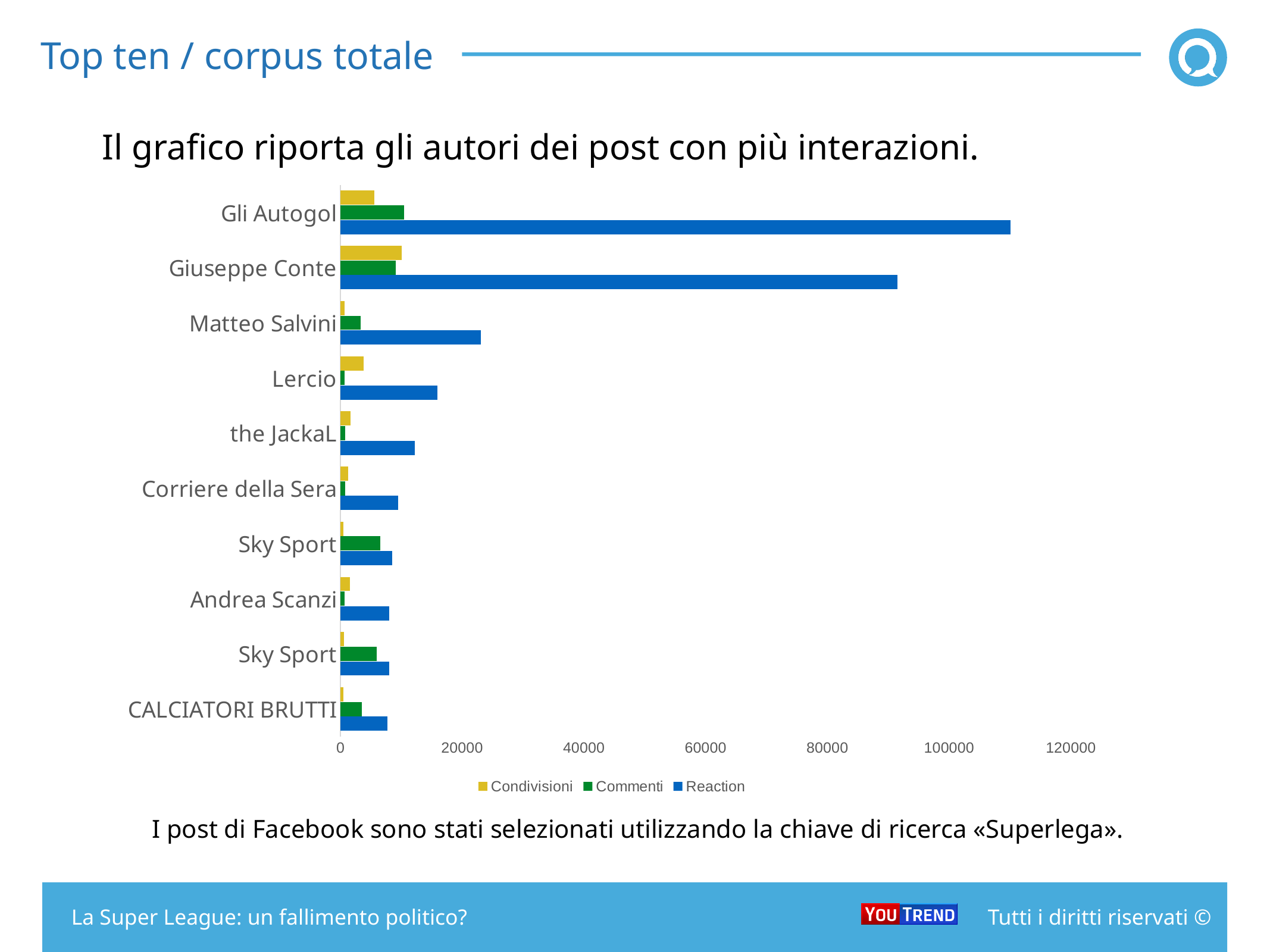
What is the title of the slide containing the chart? Top ten / corpus totale What kind of chart is shown on the slide? bar chart How many authors (categories) are plotted on the chart? 10 Which is larger, the Reaction value for Gli Autogol or for Giuseppe Conte? Gli Autogol How many series does the legend list? 3 Is the Reaction value for Gli Autogol greater or less than 100000? greater Which author has the highest Reaction value? Gli Autogol Is the Reaction value for Lercio greater or less than 20000? less Which series is shown in blue in the legend? Reaction Which is larger, the Condivisioni value for Giuseppe Conte or for Gli Autogol? Giuseppe Conte Is the Reaction value for Giuseppe Conte greater or less than 100000? less